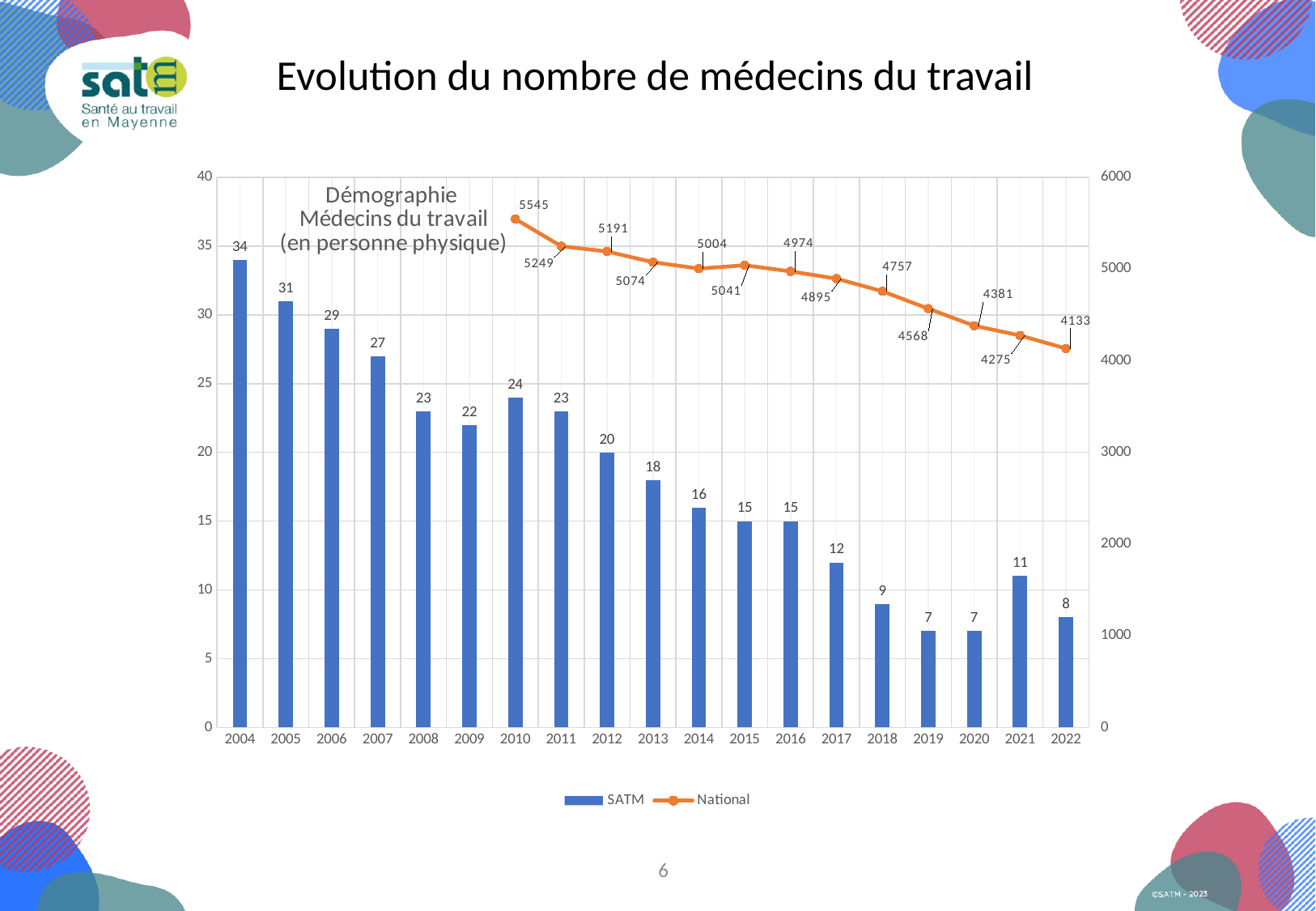
What is the National value for 2022? 4133 How many series does the legend list? 2 What is the SATM value for 2021? 11 What is the SATM value for 2004? 34 How many years are shown on the x axis? 19 What is the National value for 2010? 5545 Do the National values generally rise or fall from 2010 to 2022? fall Which is larger, the National value for 2014 or for 2015? 2015 Which year has the lowest National value? 2022 What is the difference between the SATM values for 2004 and 2022? 26 Which year has the highest SATM value? 2004 What kind of chart is this? Combined bar and line chart